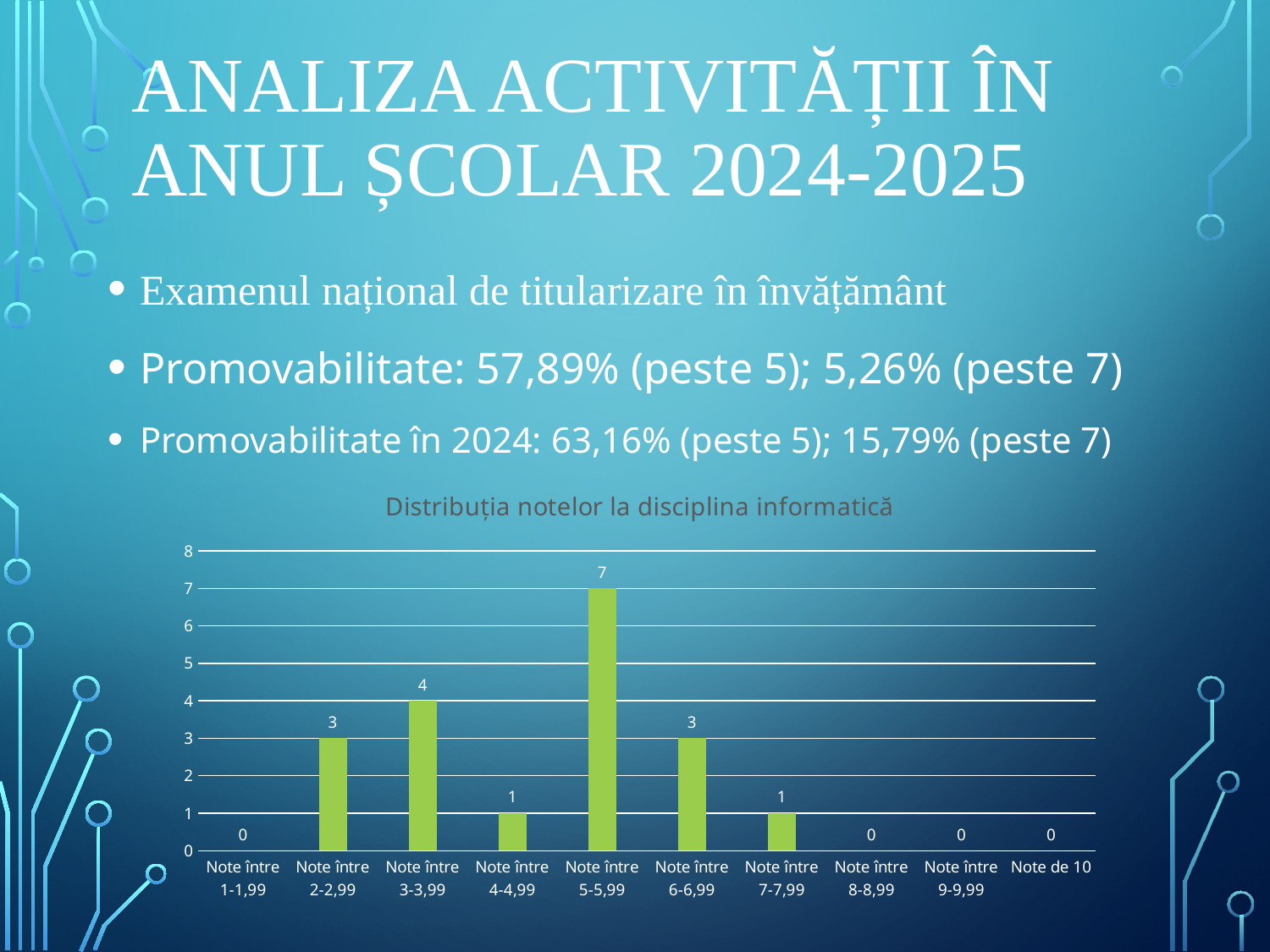
What is the total of the values for 'Note între 6-6,99' and 'Note între 7-7,99'? 4 What is the value for 'Note între 3-3,99' in the chart? 4 How many categories in the chart have a value of 0? 4 What kind of chart is shown on the slide? Bar chart Which category has the highest value in the chart? Note între 5-5,99 Which is larger: the value for 'Note între 2-2,99' or the value for 'Note între 4-4,99'? Note între 2-2,99 What is the value for 'Note între 1-1,99' in the chart? 0 What is the difference between the values for 'Note între 5-5,99' and 'Note între 3-3,99'? 3 What is the value for 'Note de 10' in the chart? 0 What is the title of the chart? Distribuția notelor la disciplina informatică What is the value for 'Note între 5-5,99' in the chart? 7 How many categories are shown on the x axis of the chart? 10